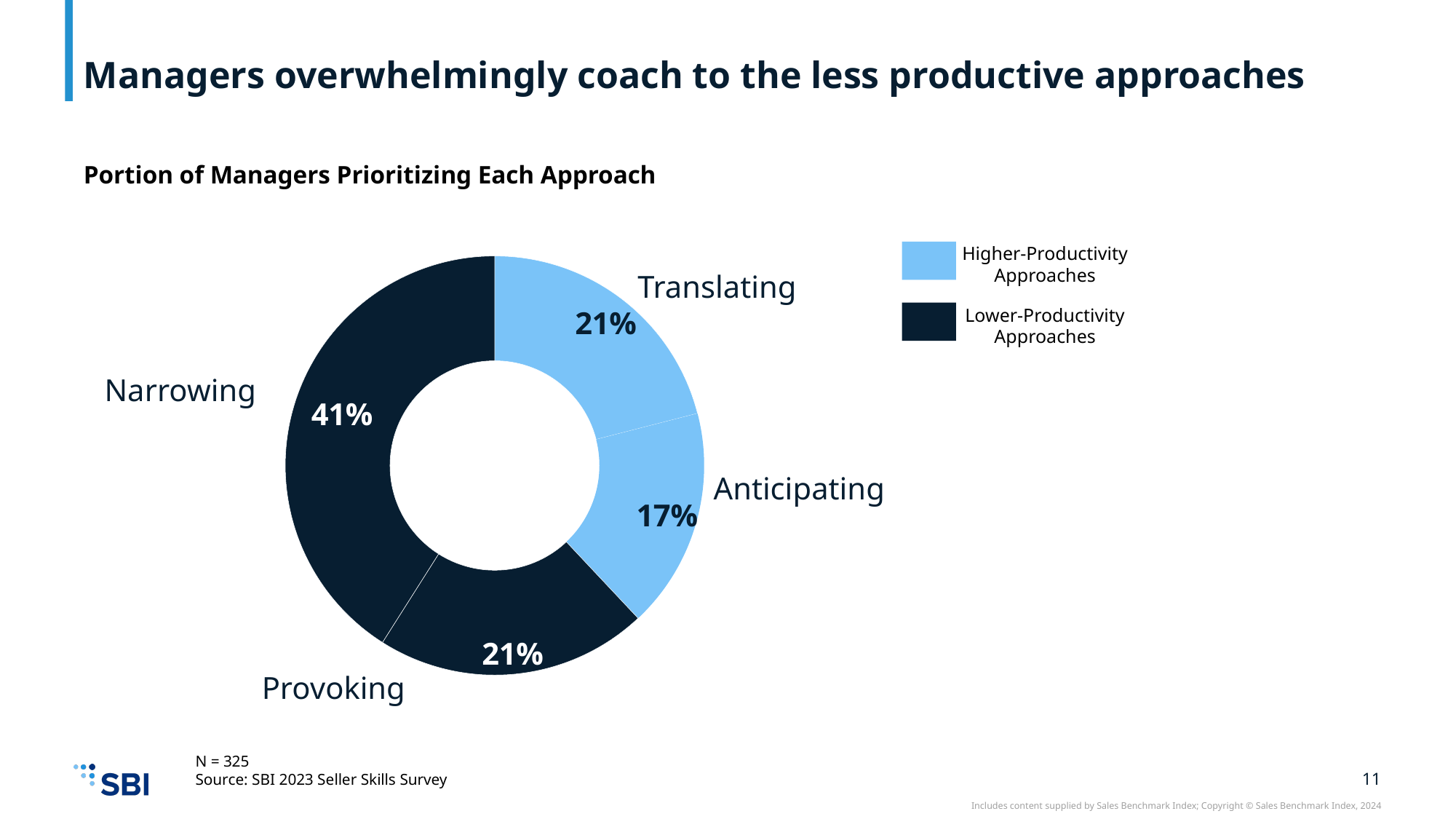
How many approaches are shown in the chart? 4 Which approach has the largest share of managers prioritizing it? Narrowing What share of managers prioritize the Narrowing approach? 41% How many entries does the legend list? 2 What share of managers prioritize the Provoking approach? 21% What share of managers prioritize the Translating approach? 21% What is the difference in percentage points between the Narrowing and Anticipating shares? 24 percentage points Which legend category do the dark-coloured slices represent? Lower-Productivity Approaches Which approach has the smallest share of managers prioritizing it? Anticipating What share of managers prioritize the Anticipating approach? 17% What type of chart is shown on the slide? Donut (pie) chart Which is larger, the share for Narrowing or the share for Provoking? Narrowing